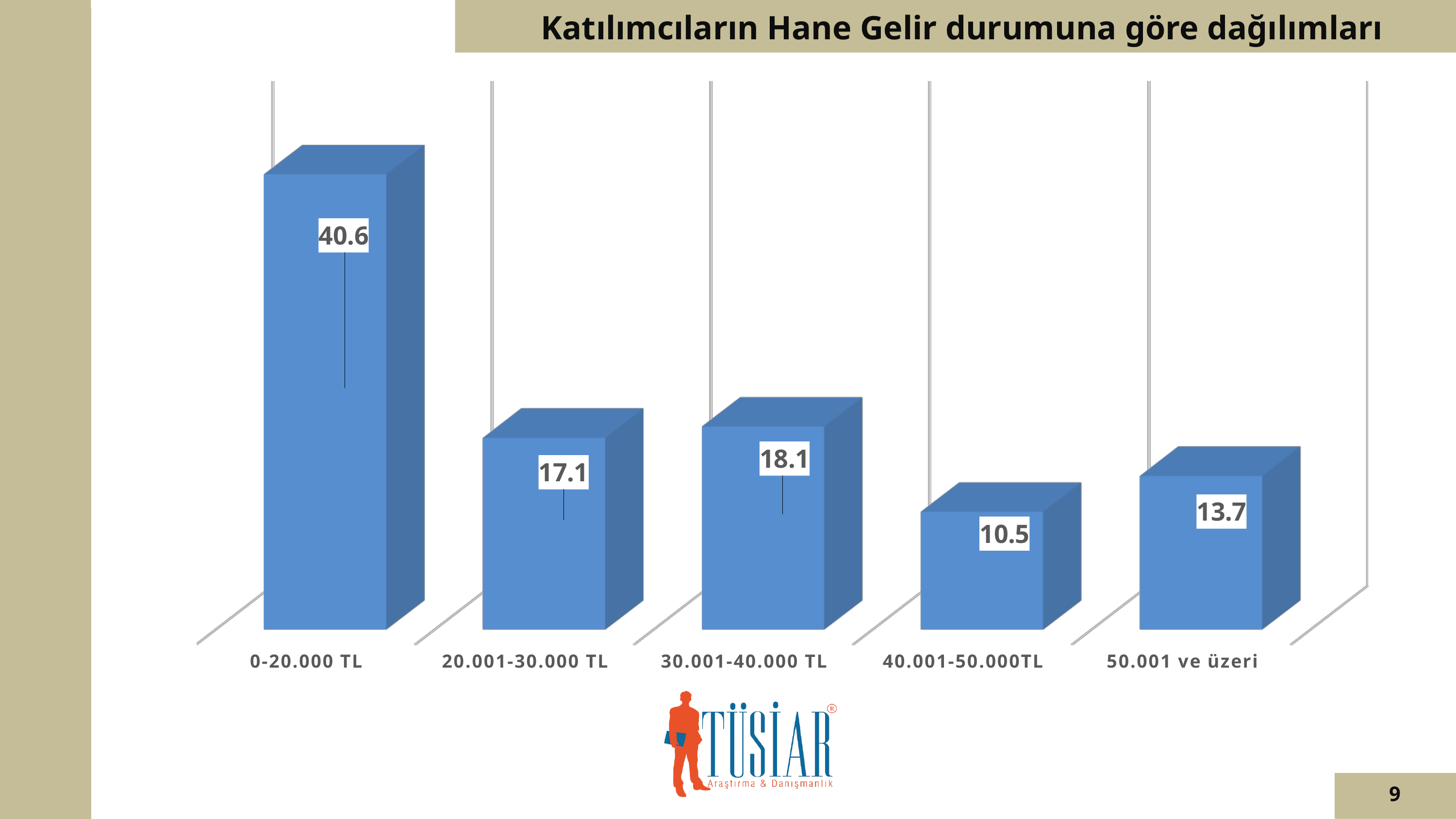
What is the value for the 0-20.000 TL category? 40.6 What is the difference between the values for 50.001 ve üzeri and 40.001-50.000TL? 3.2 Which is larger, the value for 20.001-30.000 TL or the value for 30.001-40.000 TL? 30.001-40.000 TL Which category has the highest value? 0-20.000 TL Which category has the lowest value? 40.001-50.000TL What is the value for the 30.001-40.000 TL category? 18.1 What kind of chart is shown on the slide? Bar chart How many categories are shown in the chart? 5 What is the value for the 20.001-30.000 TL category? 17.1 What is the difference between the values for 0-20.000 TL and 30.001-40.000 TL? 22.5 What is the value for the 50.001 ve üzeri category? 13.7 What is the value for the 40.001-50.000TL category? 10.5